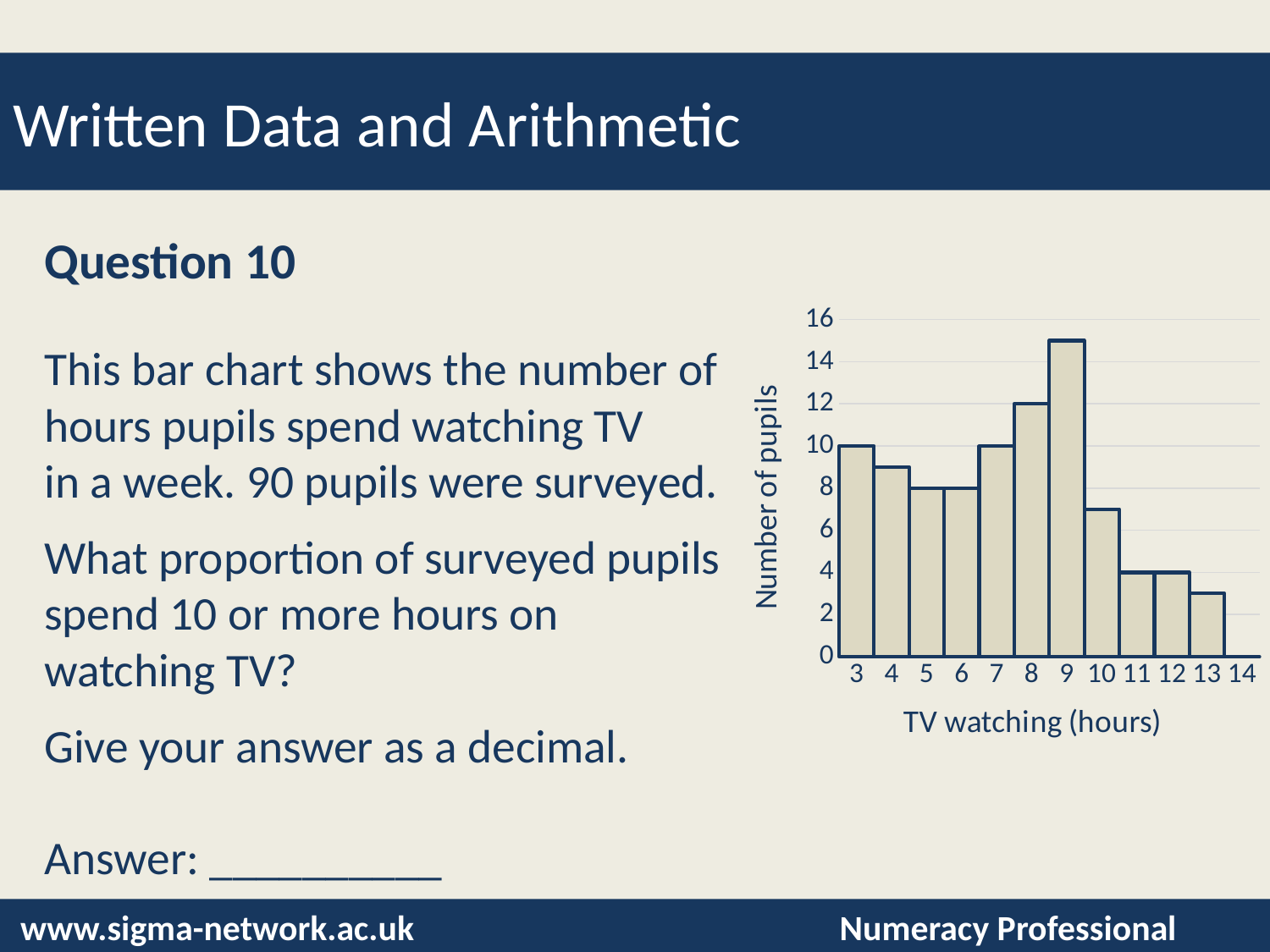
Is the number of pupils for 9 hours greater or less than 14? greater Is the number of pupils for 13 hours greater or less than 4? less How many bars are plotted in the chart? 11 What is the label of the vertical axis of the chart? Number of pupils Which has more pupils: 8 hours or 7 hours of TV watching? 8 hours What type of chart is shown on the slide? bar chart What is the number of pupils for 8 hours of TV watching? 12 Which TV watching hours category has the highest number of pupils? 9 How many pupils watch 3 hours of TV according to the chart? 10 What is the difference between the number of pupils for 8 hours and for 3 hours? 2 What is the number of pupils for 11 hours of TV watching? 4